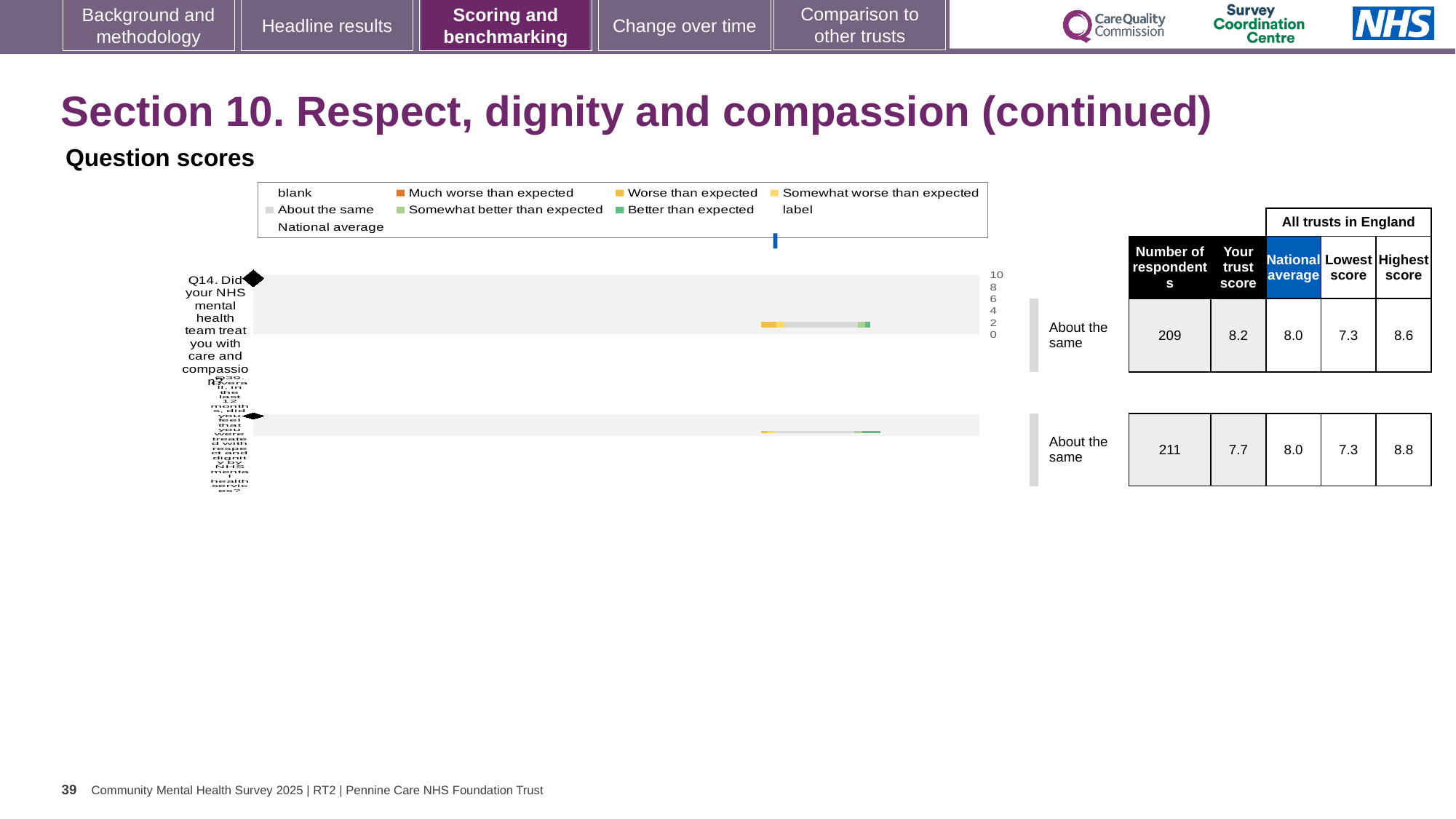
What is the national average score for Q14? 8.0 How many respondents answered Q14? 209 What is the trust score for Q39 (respect and dignity)? 7.7 What is the difference between the trust scores for Q14 and Q39? 0.5 What is the trust score for Q14 (care and compassion)? 8.2 Which question has the higher trust score, Q14 or Q39? Q14 How many questions are plotted in the question scores chart? 2 What is the highest score among all trusts in England for Q39? 8.8 What is the highest tick value shown on the score axis of the chart? 10 What kind of chart is used to show the question scores? bar chart What benchmark category is shown for Q39? About the same How many entries does the legend of the question scores chart list? 9